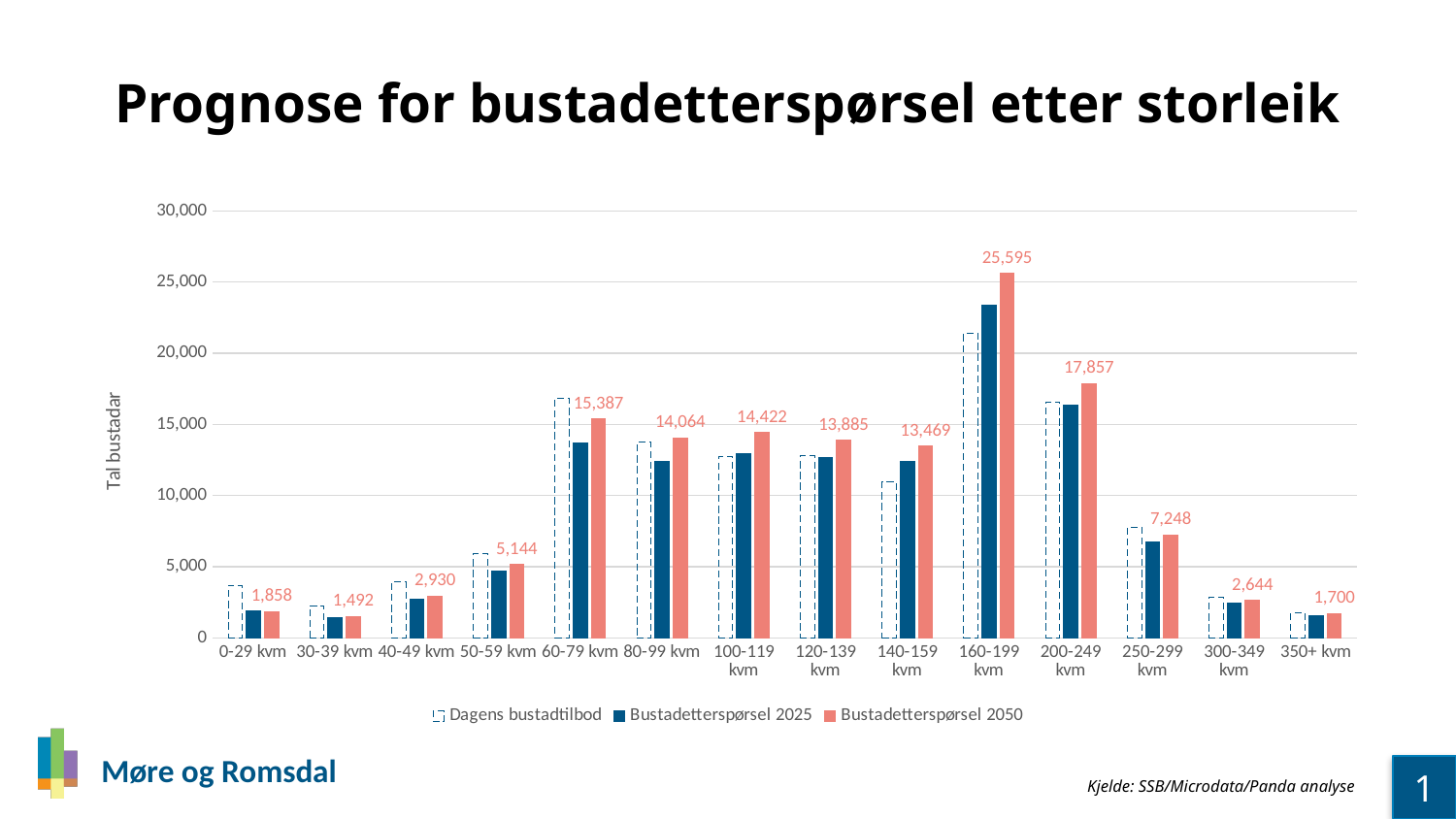
Is the Dagens bustadtilbod value for 140-159 kvm greater or less than 15,000? less How many size categories are shown on the x axis? 14 What is the Bustadetterspørsel 2050 value for the 160-199 kvm category? 25,595 Which size category has the lowest Bustadetterspørsel 2050 value? 30-39 kvm What is the Bustadetterspørsel 2050 value for the 250-299 kvm category? 7,248 How many series does the legend list? 3 What is the difference between the Bustadetterspørsel 2050 values for 160-199 kvm and 200-249 kvm? 7,738 What is the Bustadetterspørsel 2050 value for the 60-79 kvm category? 15,387 What type of chart is shown on the slide? Bar chart Which size category has the highest Bustadetterspørsel 2050 value? 160-199 kvm Which has the larger Bustadetterspørsel 2050 value: 100-119 kvm or 80-99 kvm? 100-119 kvm Is the Bustadetterspørsel 2025 value for 160-199 kvm greater or less than 20,000? greater